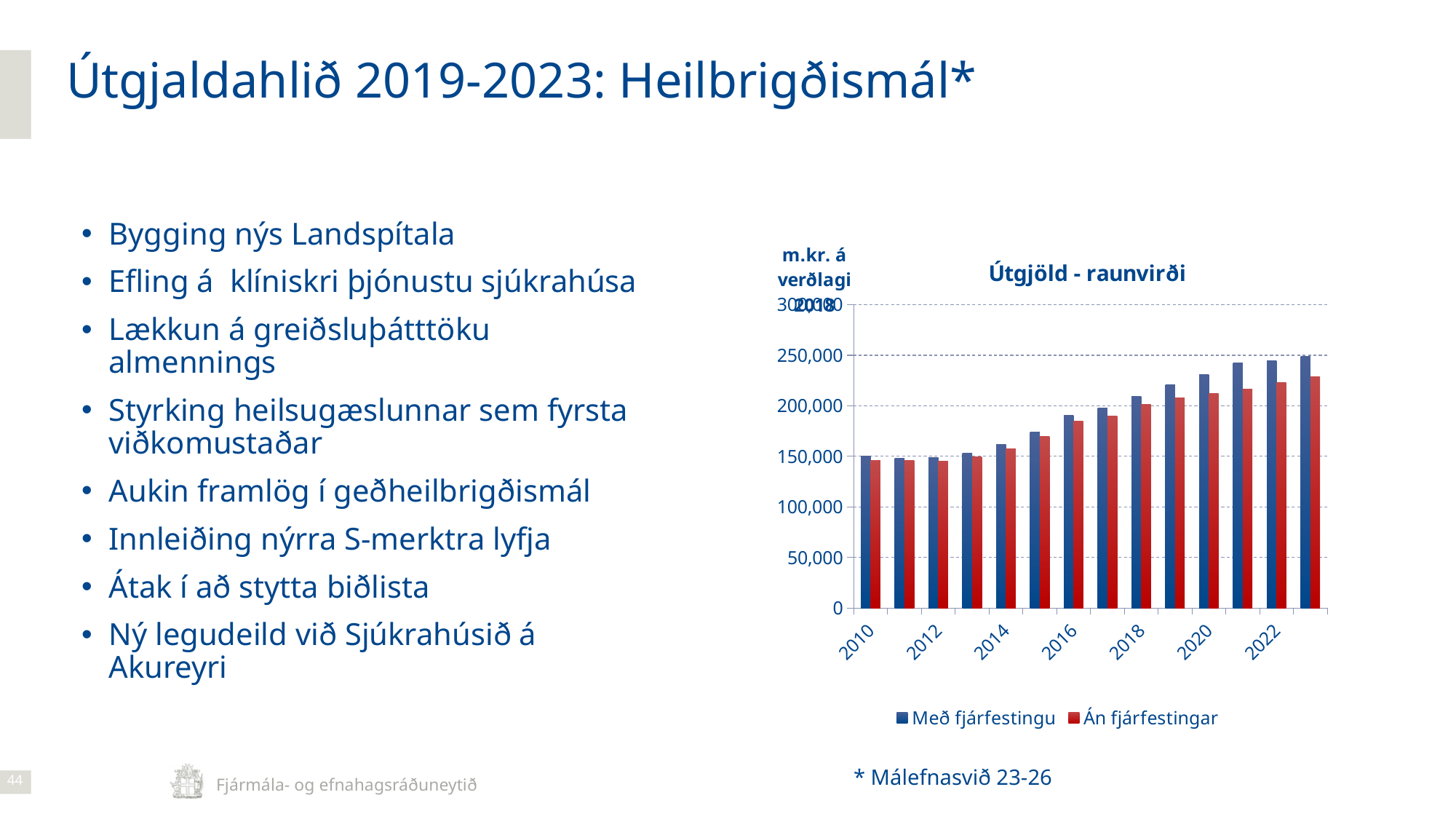
How many series does the chart legend list? 2 Is the value for Með fjárfestingu in 2020 greater or less than 200,000? greater What is the title of the chart? Útgjöld - raunvirði Do the values for Með fjárfestingu generally rise or fall from 2010 to 2023? rise Which series is shown in red in the chart? Án fjárfestingar Is the value for Með fjárfestingu in 2014 greater or less than 150,000? greater Is the value for Án fjárfestingar in 2022 greater or less than 200,000? greater What kind of chart is shown on the slide? bar chart How many years are plotted on the x axis of the chart? 14 In 2020, which series has the larger value, Með fjárfestingu or Án fjárfestingar? Með fjárfestingu Which year has the highest value for Með fjárfestingu? 2023